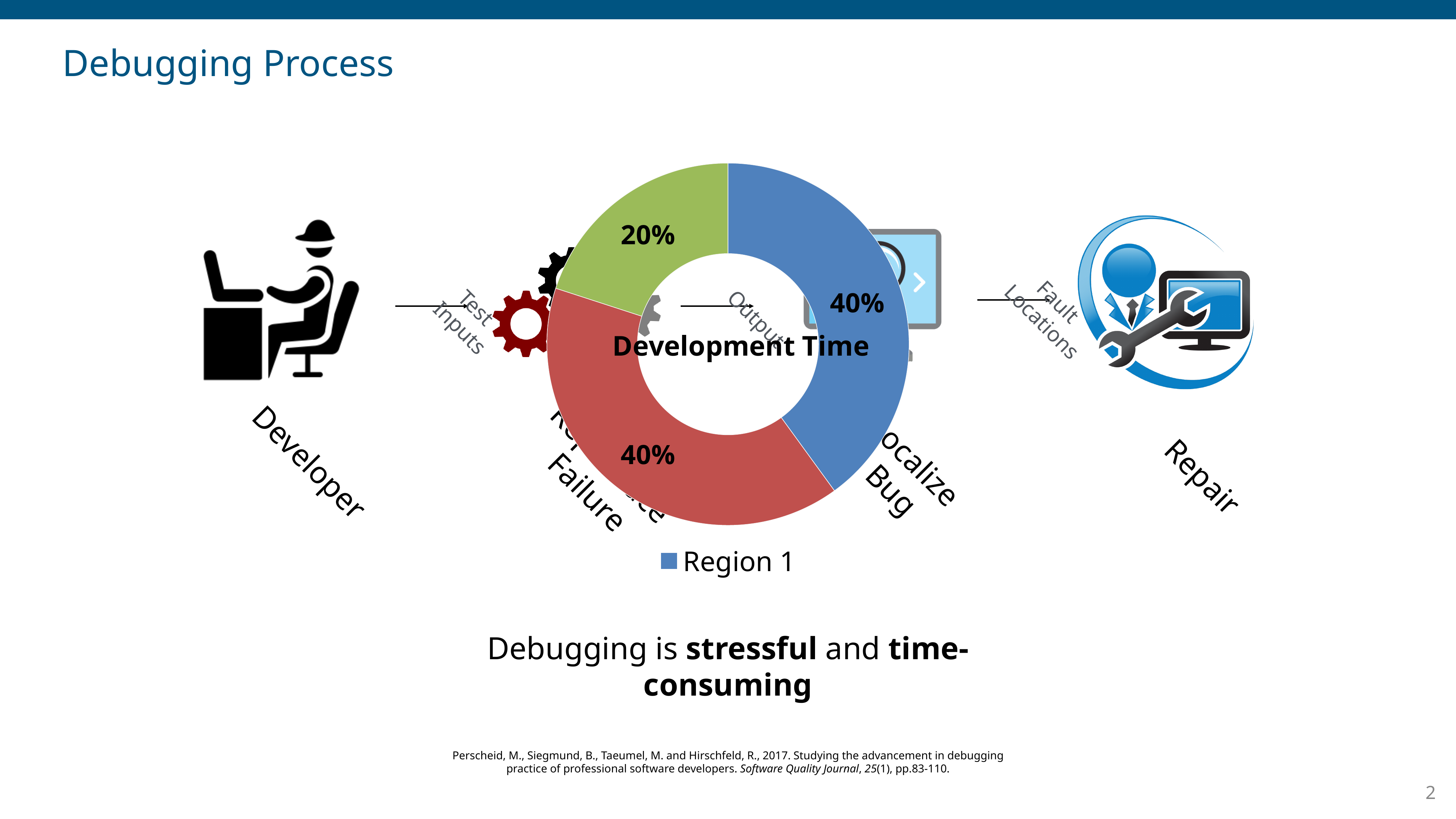
How many slices does the chart have? 3 What percentage is shown on the green slice of the chart? 20% What is the title shown in the centre of the chart? Development Time Which is larger, the blue slice or the green slice? the blue slice What is the legend entry shown below the chart? Region 1 What kind of chart is shown on the slide? doughnut chart Which slice of the chart is the smallest? the green slice What do the three slice percentages add up to? 100% What percentage is shown on the blue slice of the chart? 40% How many entries does the chart legend list? 1 By how many percentage points does the red slice exceed the green slice? 20 What percentage is shown on the red slice of the chart? 40%